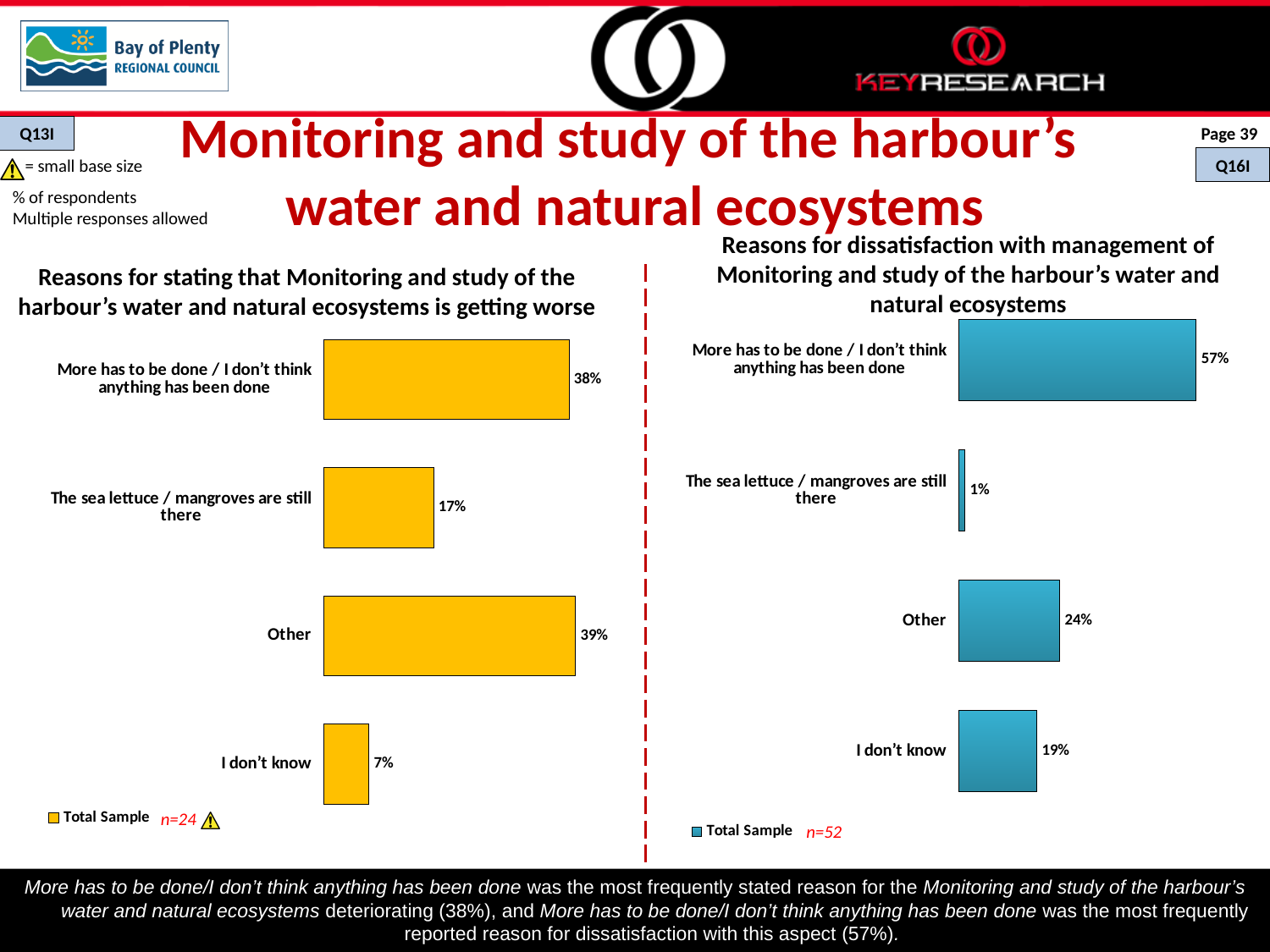
In the right chart (reasons for dissatisfaction with management), which is larger: 'Other' or 'I don't know'? Other In the right chart (reasons for dissatisfaction with management), what percentage is shown for 'More has to be done / I don't think anything has been done'? 57% In the left chart (reasons for stating it is getting worse), what percentage is shown for 'More has to be done / I don't think anything has been done'? 38% In the right chart (reasons for dissatisfaction with management), which category has the highest value? More has to be done / I don't think anything has been done In the right chart (reasons for dissatisfaction with management), what percentage is shown for 'The sea lettuce / mangroves are still there'? 1% In the left chart (reasons for stating it is getting worse), what percentage is shown for 'The sea lettuce / mangroves are still there'? 17% In the right chart (reasons for dissatisfaction with management), what is the difference between 'Other' and 'I don't know'? 5% What type of chart is the right chart (reasons for dissatisfaction with management)? Bar chart In the left chart (reasons for stating it is getting worse), what is the difference between 'Other' and 'I don't know'? 32% In the left chart (reasons for stating it is getting worse), which category has the lowest value? I don't know How many categories are shown in the left chart (reasons for stating it is getting worse)? 4 In the left chart (reasons for stating it is getting worse), which category has the highest value? Other